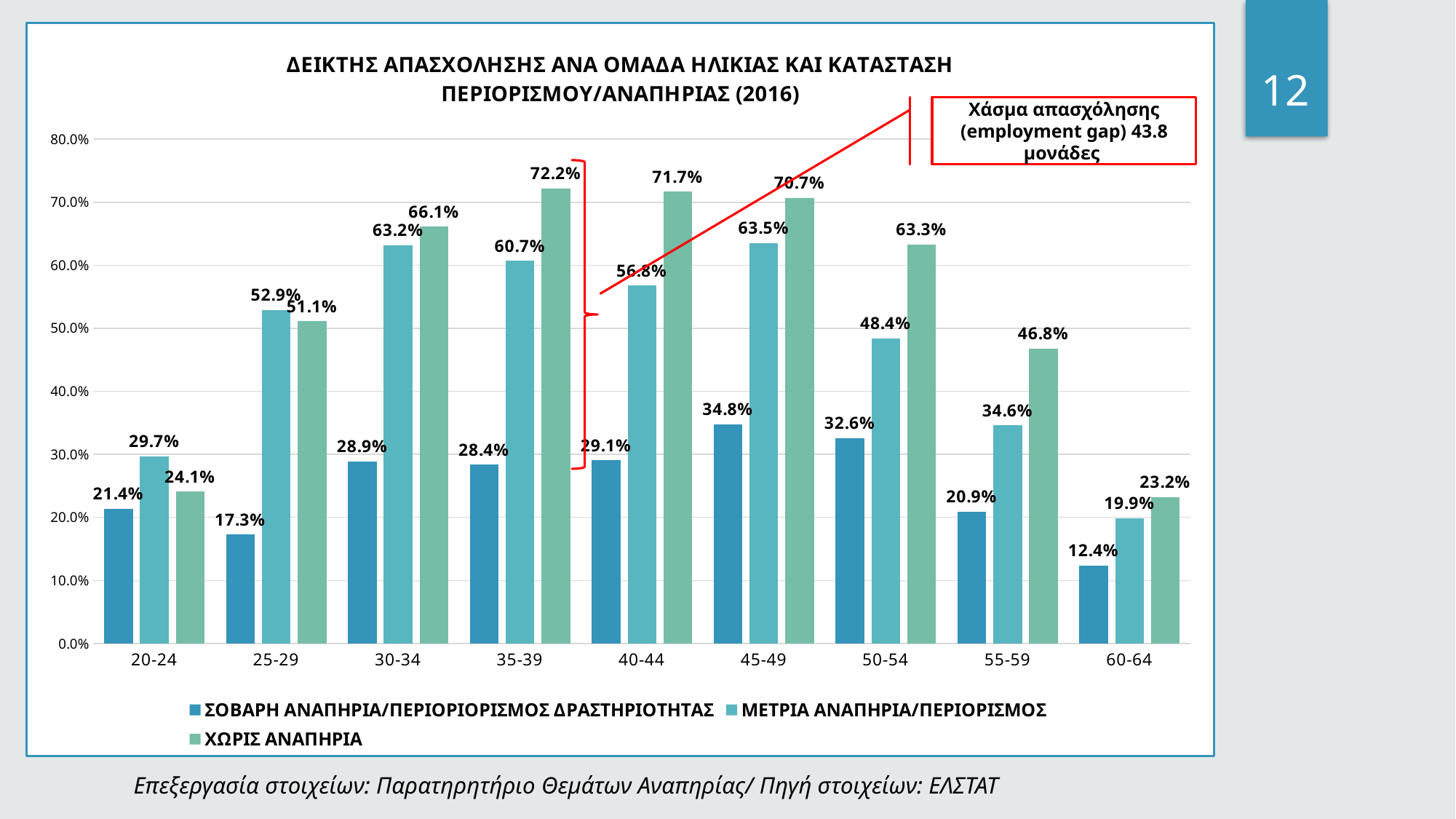
Is the ΧΩΡΙΣ ΑΝΑΠΗΡΙΑ value for the 55-59 age group greater or less than 50.0%? less What is the value for the 45-49 age group in the ΣΟΒΑΡΗ ΑΝΑΠΗΡΙΑ/ΠΕΡΙΟΡΙΟΡΙΣΜΟΣ ΔΡΑΣΤΗΡΙΟΤΗΤΑΣ series? 34.8% Which age group has the lowest value in the ΣΟΒΑΡΗ ΑΝΑΠΗΡΙΑ/ΠΕΡΙΟΡΙΟΡΙΣΜΟΣ ΔΡΑΣΤΗΡΙΟΤΗΤΑΣ series? 60-64 How many age groups are shown on the x axis? 9 What is the value for the 25-29 age group in the ΜΕΤΡΙΑ ΑΝΑΠΗΡΙΑ/ΠΕΡΙΟΡΙΣΜΟΣ series? 52.9% What is the difference between the ΧΩΡΙΣ ΑΝΑΠΗΡΙΑ value and the ΣΟΒΑΡΗ ΑΝΑΠΗΡΙΑ/ΠΕΡΙΟΡΙΟΡΙΣΜΟΣ ΔΡΑΣΤΗΡΙΟΤΗΤΑΣ value for the 35-39 age group? 43.8 percentage points What employment gap (in units) is stated in the red annotation box? 43.8 Which age group has the highest value in the ΧΩΡΙΣ ΑΝΑΠΗΡΙΑ series? 35-39 What kind of chart is shown on the slide? Bar chart For the 20-24 age group, which is larger: the ΜΕΤΡΙΑ ΑΝΑΠΗΡΙΑ/ΠΕΡΙΟΡΙΣΜΟΣ value or the ΧΩΡΙΣ ΑΝΑΠΗΡΙΑ value? ΜΕΤΡΙΑ ΑΝΑΠΗΡΙΑ/ΠΕΡΙΟΡΙΣΜΟΣ What is the value for the 35-39 age group in the ΧΩΡΙΣ ΑΝΑΠΗΡΙΑ series? 72.2% How many series does the legend list? 3